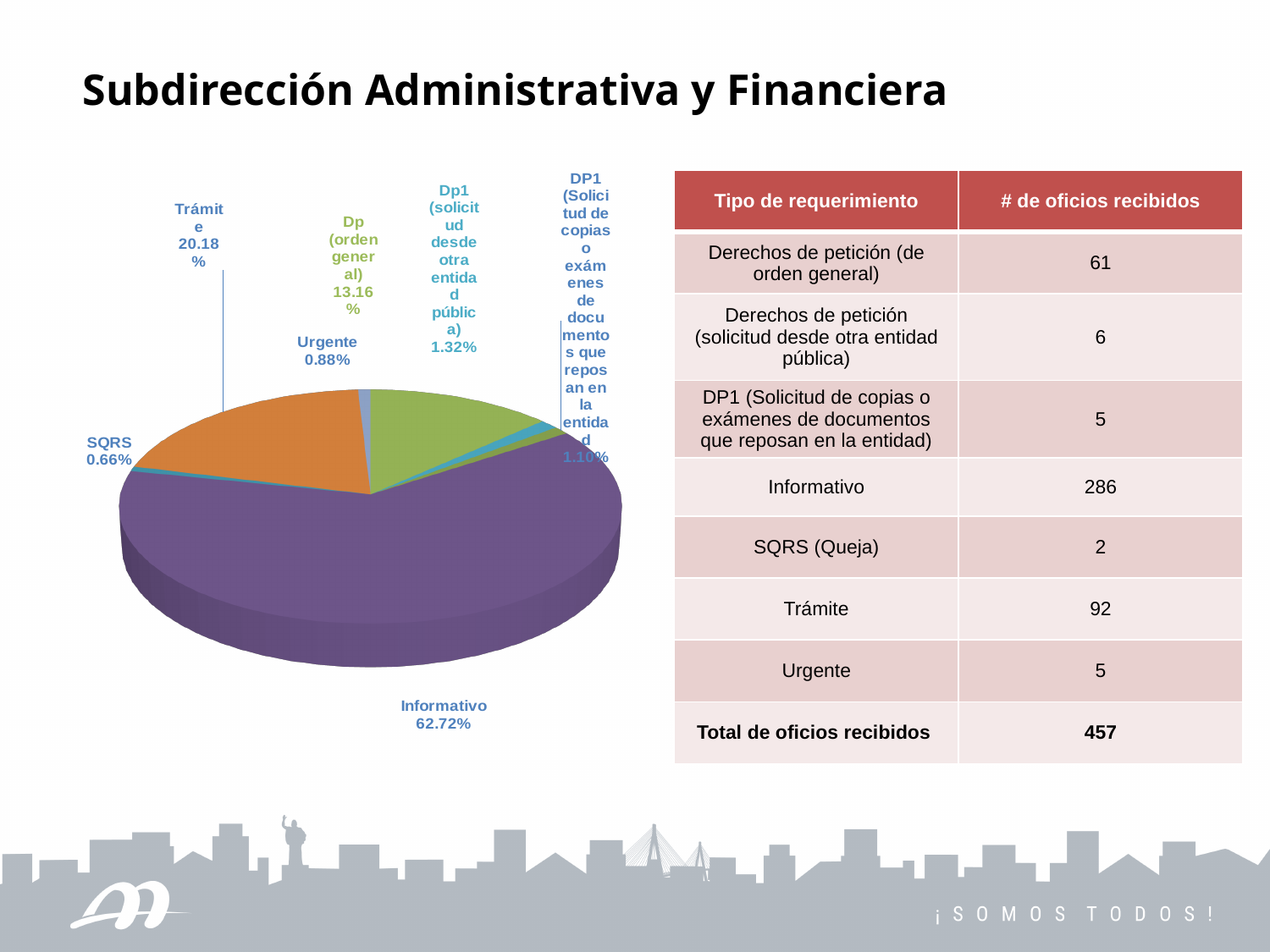
Which slice of the pie chart is the smallest? SQRS How many slices does the pie chart have? 7 Which slice is larger, Trámite or Dp (orden general)? Trámite What percentage is shown for the Urgente slice? 0.88% What is the difference in percentage points between the Informativo and Trámite slices? 42.54 What kind of chart is shown on the slide? pie chart What colour is the Informativo slice in the pie chart? purple What percentage is shown for the SQRS slice? 0.66% What percentage does the Informativo slice represent in the pie chart? 62.72% What percentage is shown for the Dp (orden general) slice? 13.16% Which slice of the pie chart is the largest? Informativo What percentage does the Trámite slice represent in the pie chart? 20.18%